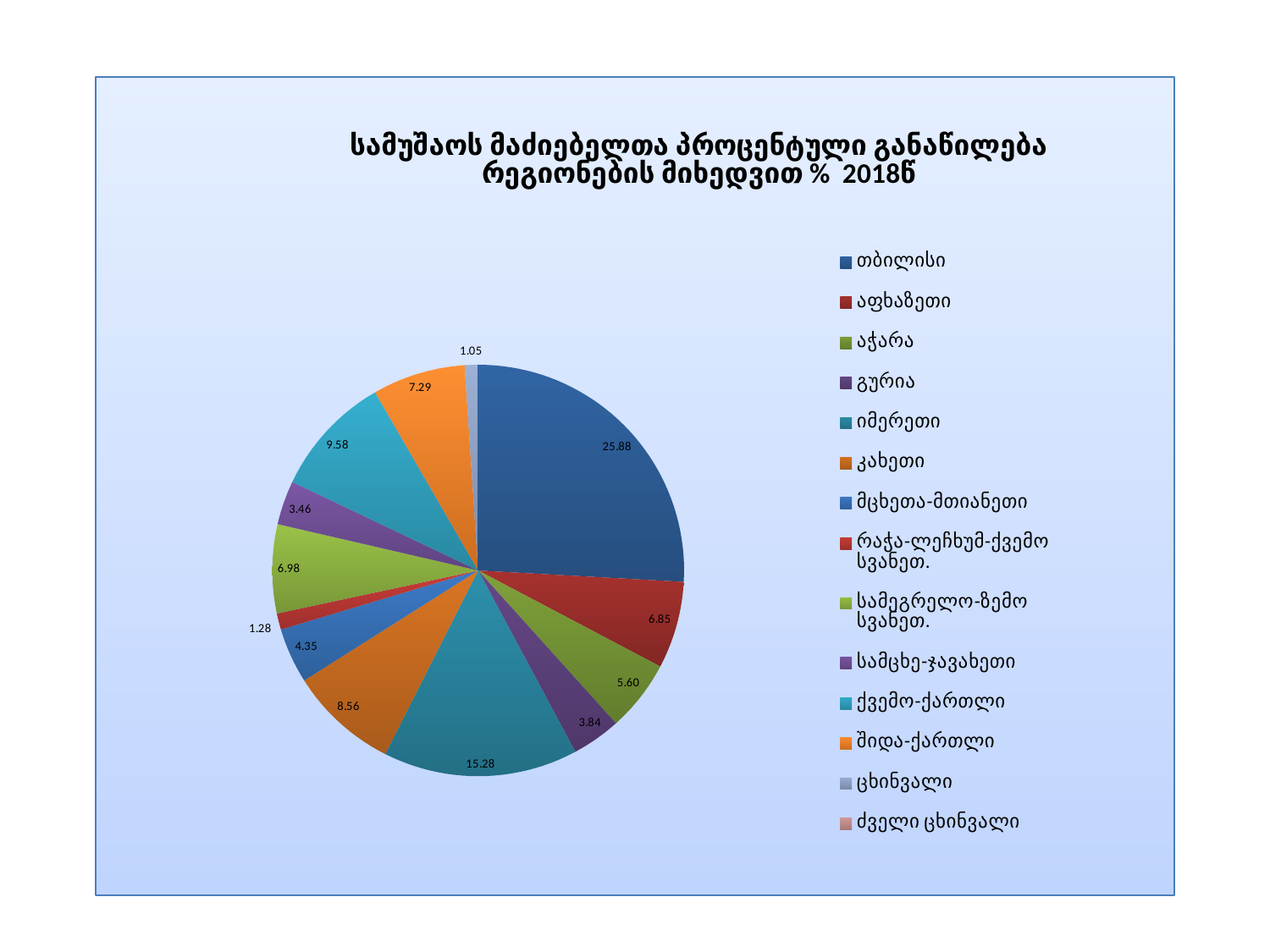
What value is shown for the იმერეთი slice? 15.28 What is the difference between the values for თბილისი and იმერეთი? 10.60 How many entries does the legend list? 14 Which region has the largest slice of the pie? თბილისი Which slice is larger, აფხაზეთი or აჭარა? აფხაზეთი What percentage of the pie is labelled for თბილისი? 25.88 What value is shown for the კახეთი slice? 8.56 What value is shown for the რაჭა-ლეჩხუმ-ქვემო სვანეთ. slice? 1.28 What type of chart is shown on the slide? Pie chart Which year is stated in the chart title? 2018 What value is shown for the ქვემო-ქართლი slice? 9.58 Which slice is larger, იმერეთი or ქვემო-ქართლი? იმერეთი